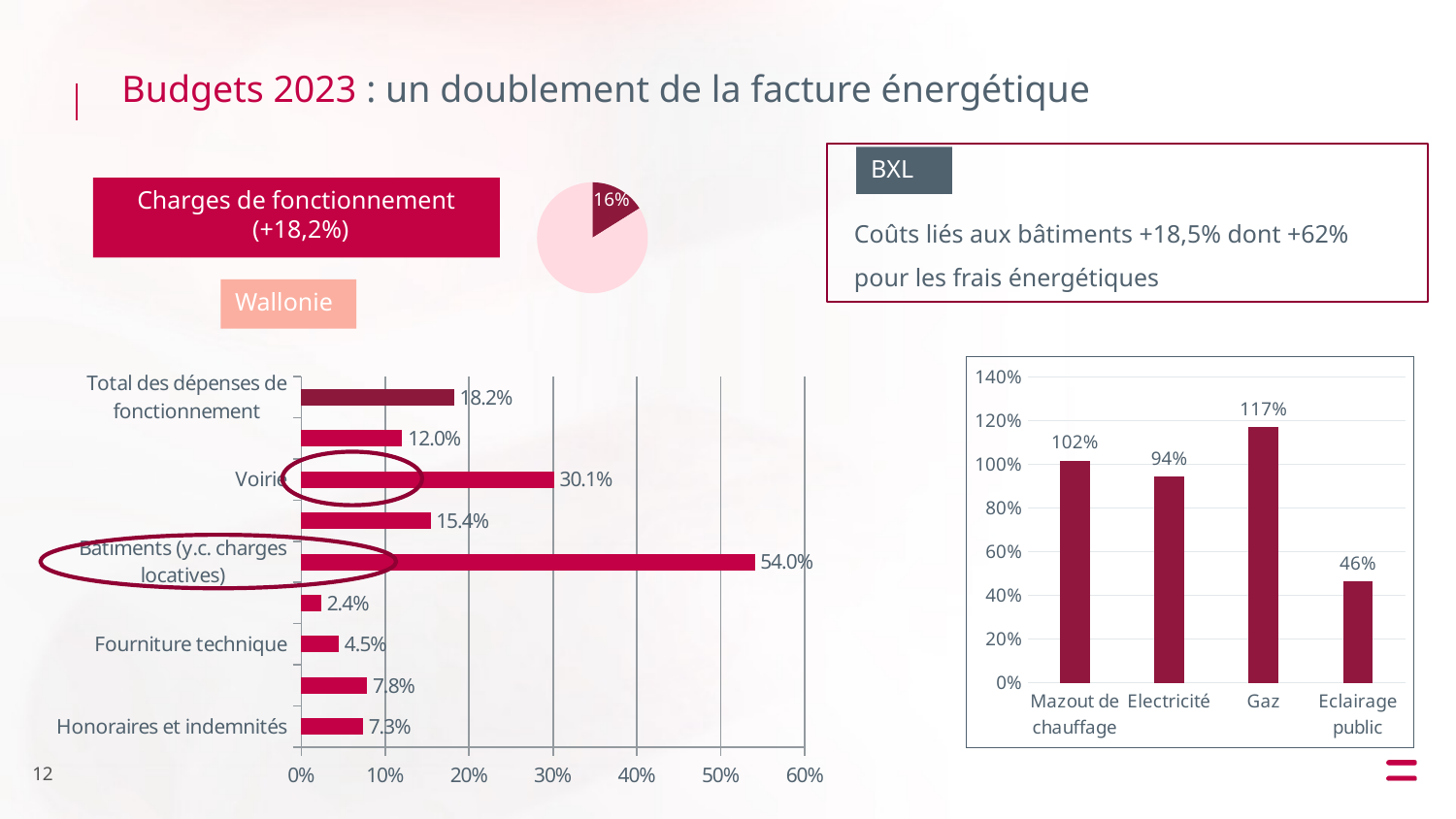
In the horizontal bar chart on the left, what is the value for Voirie? 30.1% In the horizontal bar chart on the left, which is larger: Fourniture technique or Honoraires et indemnités? Honoraires et indemnités In the horizontal bar chart on the left, how many bars are plotted? 9 In the vertical bar chart on the right, what is the value for Eclairage public? 46% In the vertical bar chart on the right, what is the difference between the values for Mazout de chauffage and Electricité? 8% In the vertical bar chart on the right, how many categories are shown? 4 In the horizontal bar chart on the left, what is the value for Bâtiments (y.c. charges locatives)? 54.0% In the vertical bar chart on the right, what is the value for Gaz? 117% In the horizontal bar chart on the left, what is the value for Honoraires et indemnités? 7.3% In the vertical bar chart on the right, which category has the highest value? Gaz What percentage is shown on the small pie chart near the top of the slide? 16% In the vertical bar chart on the right, which category has the lowest value? Eclairage public